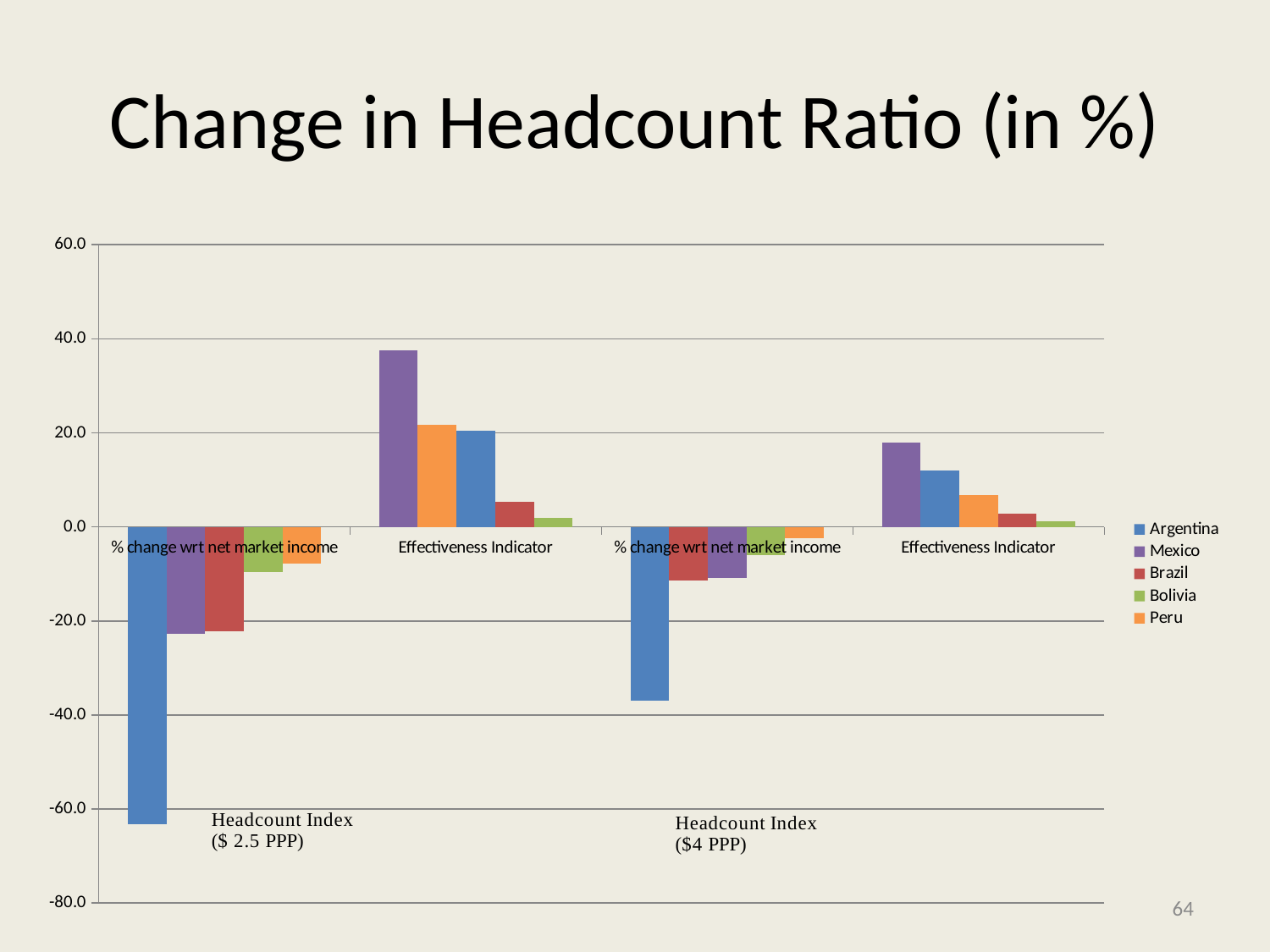
How many series does the legend list? 5 Which country has the lowest value in the '% change wrt net market income' group for the Headcount Index ($ 2.5 PPP)? Argentina In the 'Effectiveness Indicator' group for the Headcount Index ($4 PPP), which is larger, the value for Mexico or the value for Argentina? Mexico What is the title of the chart on the slide? Change in Headcount Ratio (in %) Is the value for Argentina in the '% change wrt net market income' group for the Headcount Index ($4 PPP) greater or less than -20.0? less Is the value for Mexico in the 'Effectiveness Indicator' group for the Headcount Index ($4 PPP) greater or less than 20.0? less Is the value for Argentina in the '% change wrt net market income' group for the Headcount Index ($ 2.5 PPP) greater or less than -60.0? less Which country has the highest value in the 'Effectiveness Indicator' group for the Headcount Index ($ 2.5 PPP)? Mexico Which country has the lowest value in the 'Effectiveness Indicator' group for the Headcount Index ($4 PPP)? Bolivia What kind of chart is shown on the slide? bar chart How many category groups are plotted along the x axis? 4